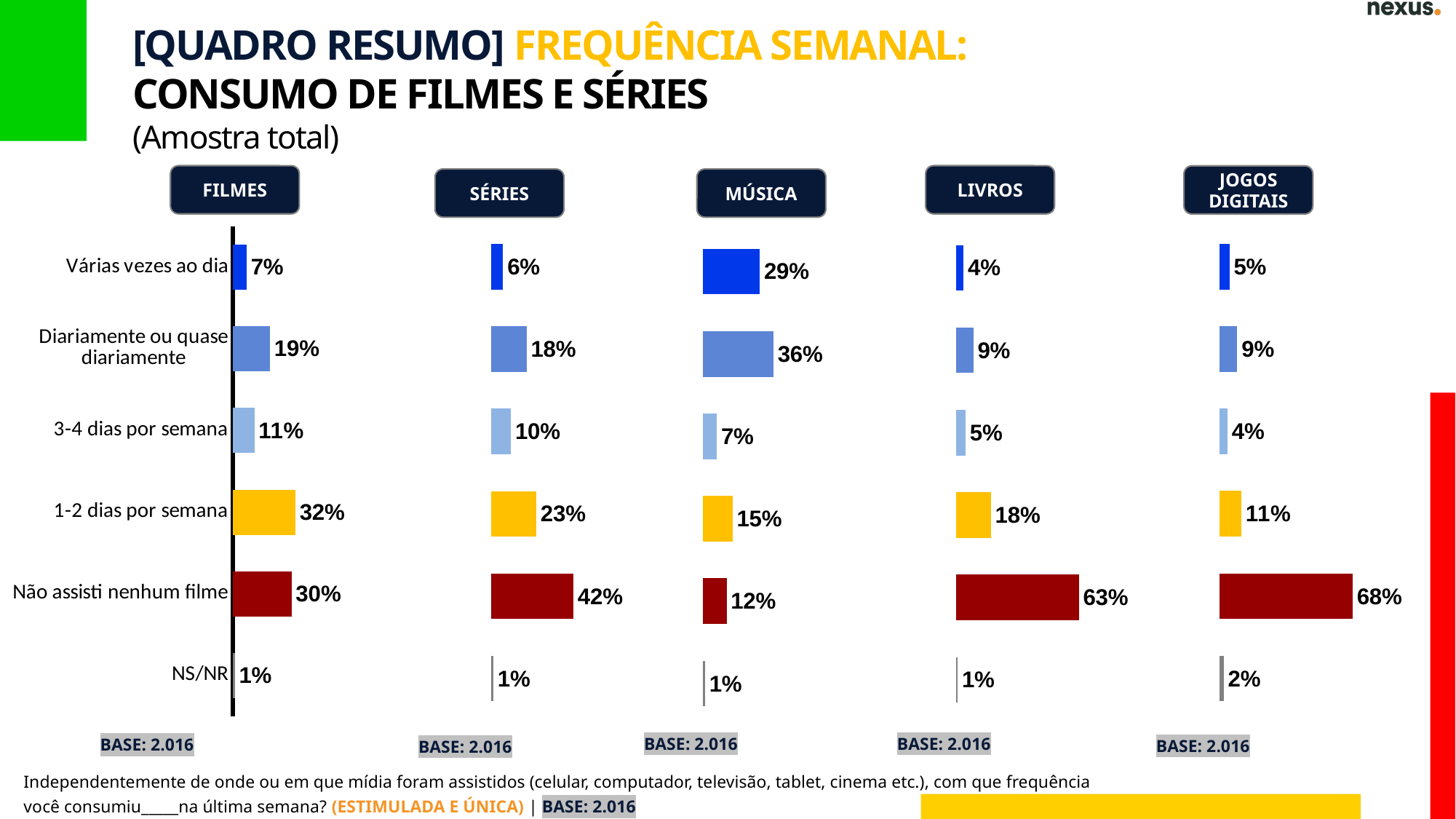
In the SÉRIES chart, what is the difference between "Não assisti nenhum filme" and "1-2 dias por semana"? 19% In the LIVROS chart, what is the difference between "Não assisti nenhum filme" and "1-2 dias por semana"? 45% In the JOGOS DIGITAIS chart, what is the value for "Não assisti nenhum filme"? 68% In the FILMES chart, what is the value for "1-2 dias por semana"? 32% In the MÚSICA chart, which category has the lowest value? NS/NR In the MÚSICA chart, what is the value for "Diariamente ou quase diariamente"? 36% What type of chart is used for the SÉRIES data? Bar chart Which is larger: "Várias vezes ao dia" in the MÚSICA chart or "Várias vezes ao dia" in the FILMES chart? MÚSICA In the LIVROS chart, which category has the highest value? Não assisti nenhum filme How many categories does the FILMES chart show? 6 What base (sample size) is shown under each chart? BASE: 2.016 In the JOGOS DIGITAIS chart, what is the value for "NS/NR"? 2%